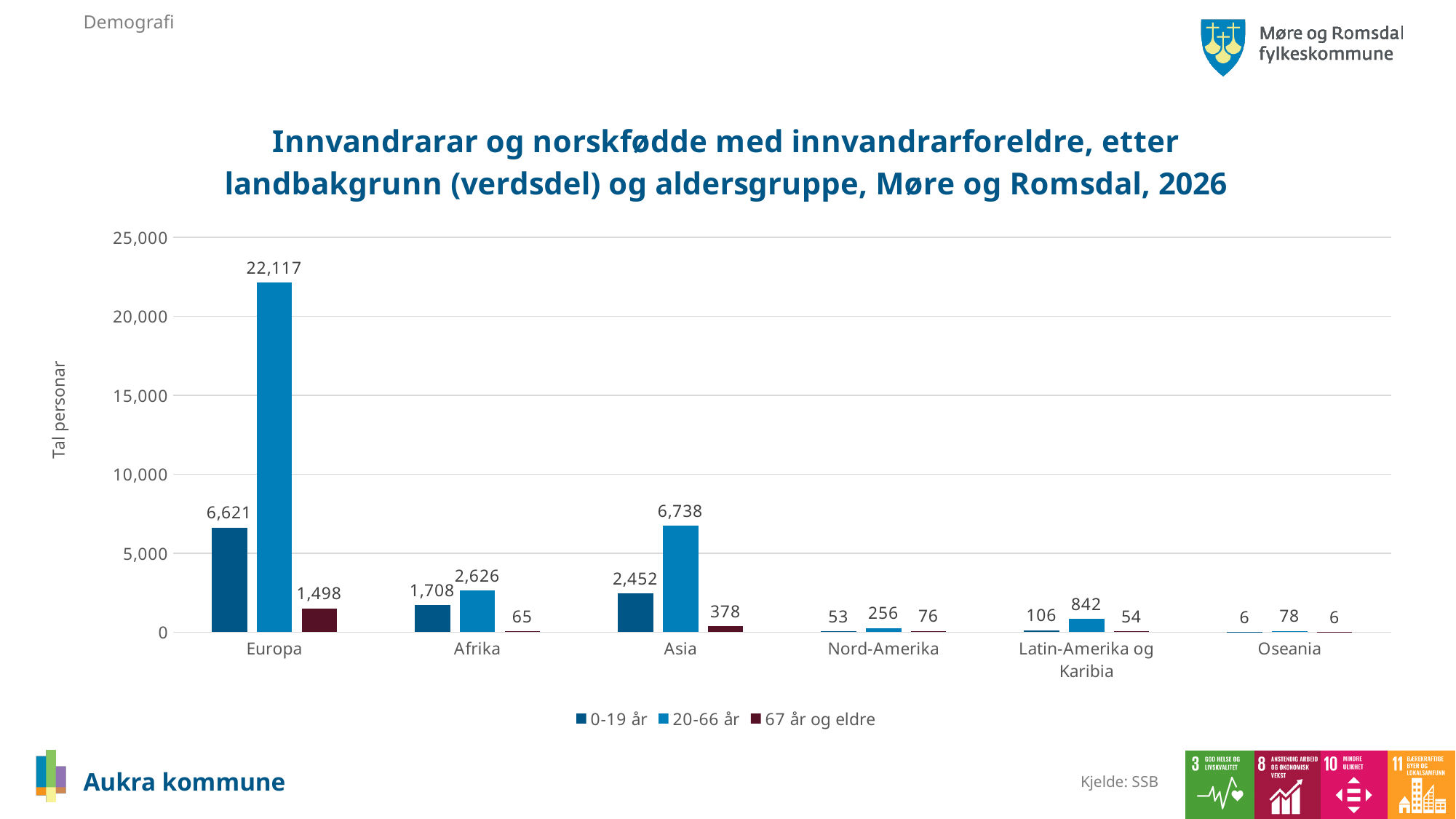
How many series does the legend list? 3 What is the total of the three age-group values for Nord-Amerika? 385 What is the difference between the 20-66 år values for Asia and Afrika? 4,112 Which is larger: the 0-19 år value for Asia or the 0-19 år value for Afrika? Asia What is the value for the 20-66 år series for Europa? 22,117 Is the 20-66 år value for Europa greater or less than 20,000? greater How many categories are shown on the x axis? 6 Which category has the lowest value for the 0-19 år series? Oseania What kind of chart is shown on the slide? bar chart Which category has the highest value for the 20-66 år series? Europa What is the value for the 0-19 år series for Latin-Amerika og Karibia? 106 What is the value for the 67 år og eldre series for Asia? 378